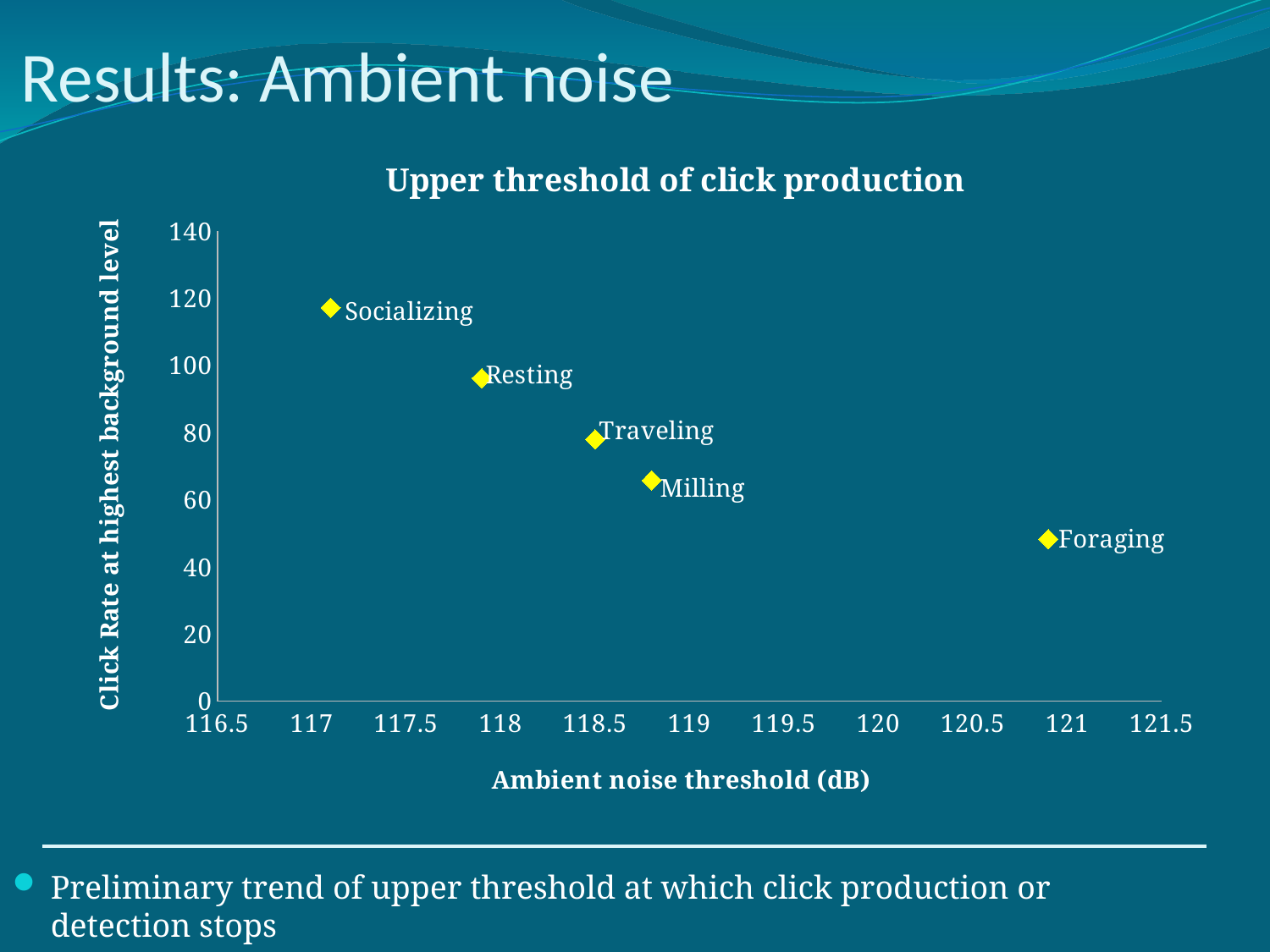
As ambient noise threshold increases along the x axis, does the click rate rise or fall? fall Is the click rate value for Foraging greater or less than 60? less Which behavior has the highest click rate at highest background level? Socializing What is the title of the chart? Upper threshold of click production Which behavior has the highest ambient noise threshold? Foraging Which behavior has the lowest click rate at highest background level? Foraging Is the click rate value for Socializing greater or less than 100? greater What is the label of the x axis? Ambient noise threshold (dB) Which has a higher click rate at highest background level, Resting or Milling? Resting What type of chart is shown on the slide? scatter chart Which behavior has the lowest ambient noise threshold? Socializing How many labeled data points are plotted on the chart? 5